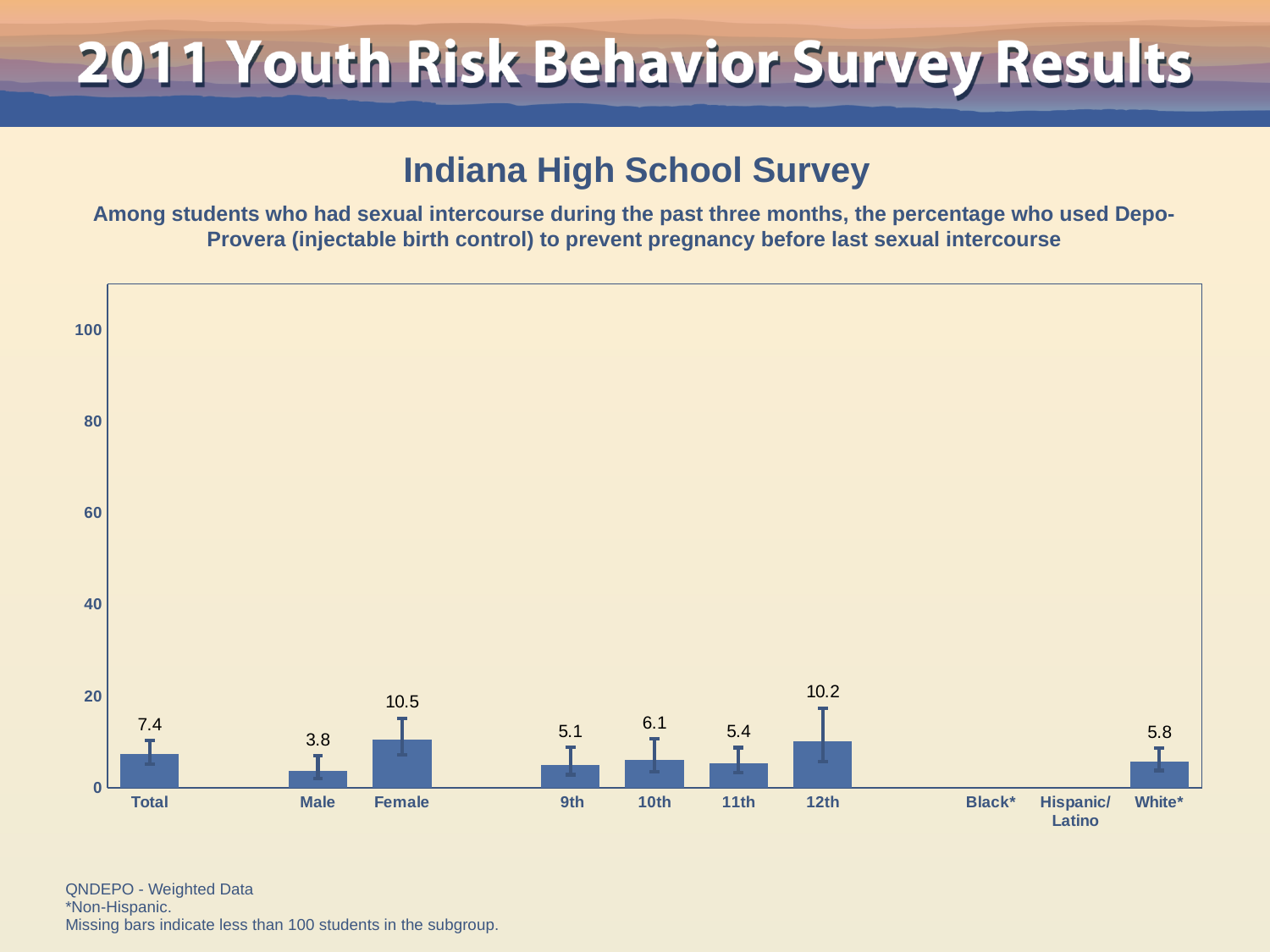
Which category has the highest value? Female What is the value for Female? 10.5 What is the difference between the Female and Male values? 6.7 What is the value for 12th? 10.2 Which categories have no bar plotted? Black* and Hispanic/Latino What kind of chart is shown? bar chart Which is larger, the value for 10th or the value for 11th? 10th What is the value for White*? 5.8 Is the value for 12th greater or less than 20? less How many categories are labeled on the x axis? 10 What is the value for Total? 7.4 Which category with a plotted bar has the lowest value? Male